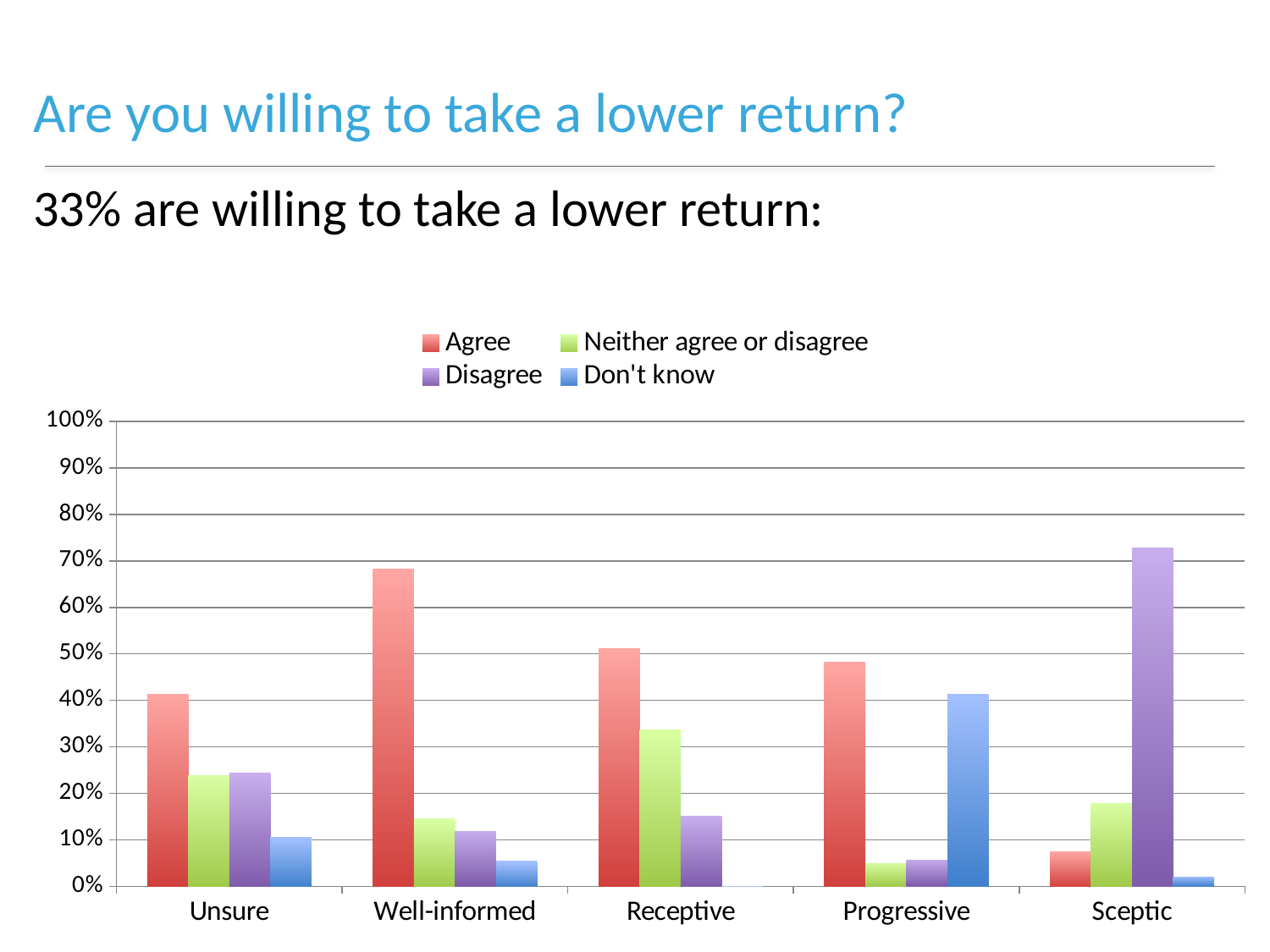
Is the Don't know value for Progressive greater or less than 30%? greater Is the Agree value for Unsure greater or less than 50%? less Which is larger, the Agree value for Unsure or the Agree value for Sceptic? Unsure What kind of chart is shown on the slide? bar chart Which colour represents the Agree series in the legend? red How many categories are shown along the x axis? 5 Is the Agree value for Well-informed greater or less than 60%? greater Which category has the lowest Agree value? Sceptic Which category has the highest Agree value? Well-informed How many series does the legend list? 4 Which category has the highest Disagree value? Sceptic